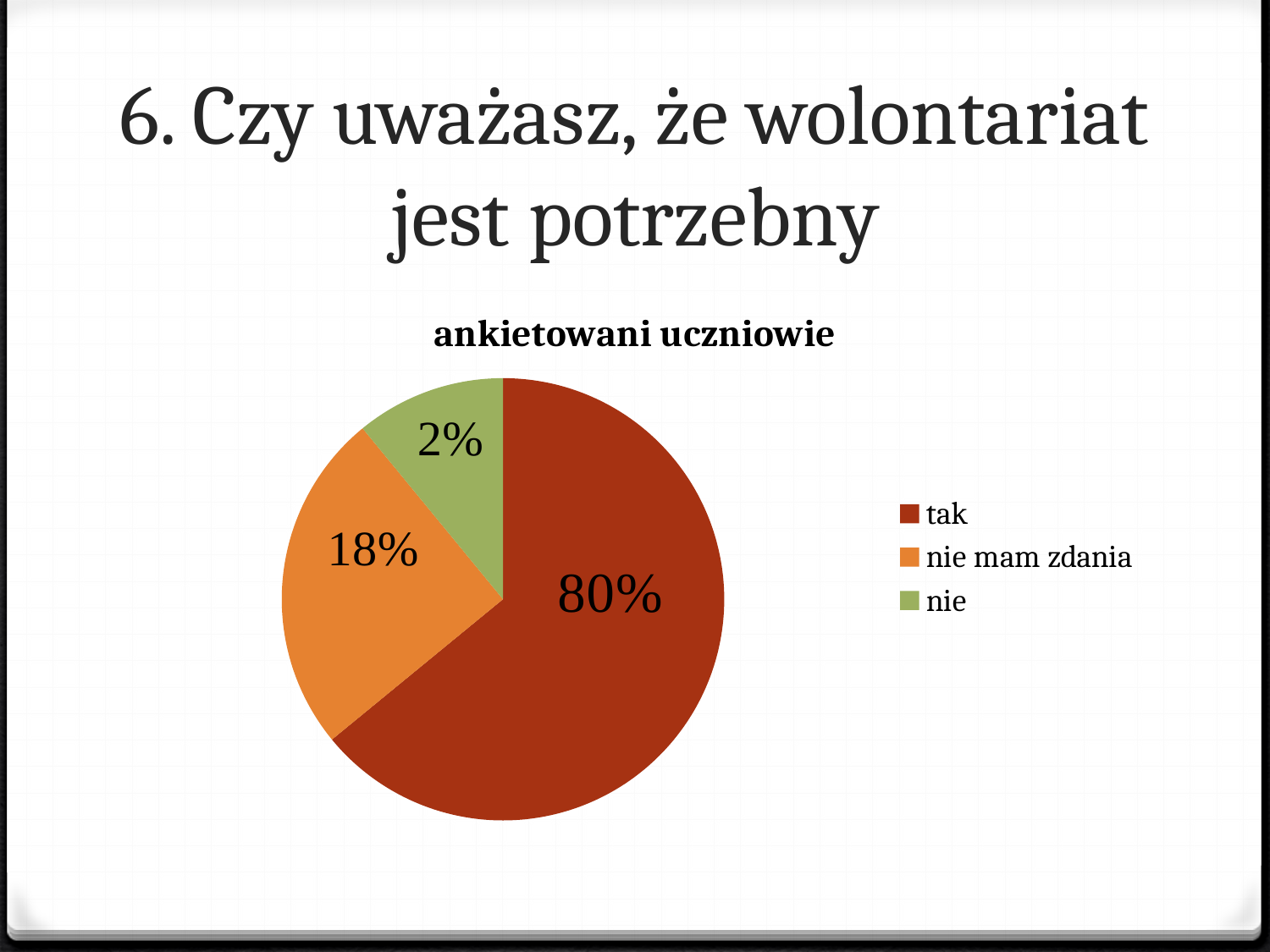
What is the title of the chart? ankietowani uczniowie Which is larger, the share for "nie mam zdania" or the share for "nie"? nie mam zdania What kind of chart is shown on the slide? pie chart What is the difference in percentage points between "tak" and "nie mam zdania"? 62 What percentage of the pie is labelled for "tak"? 80% How many entries does the legend list? 3 Which category has the smallest share of the pie? nie Which category has the largest share of the pie? tak How many slices does the pie chart have? 3 What percentage of the pie is labelled for "nie mam zdania"? 18% What percentage of the pie is labelled for "nie"? 2% What colour is the slice for "nie"? green